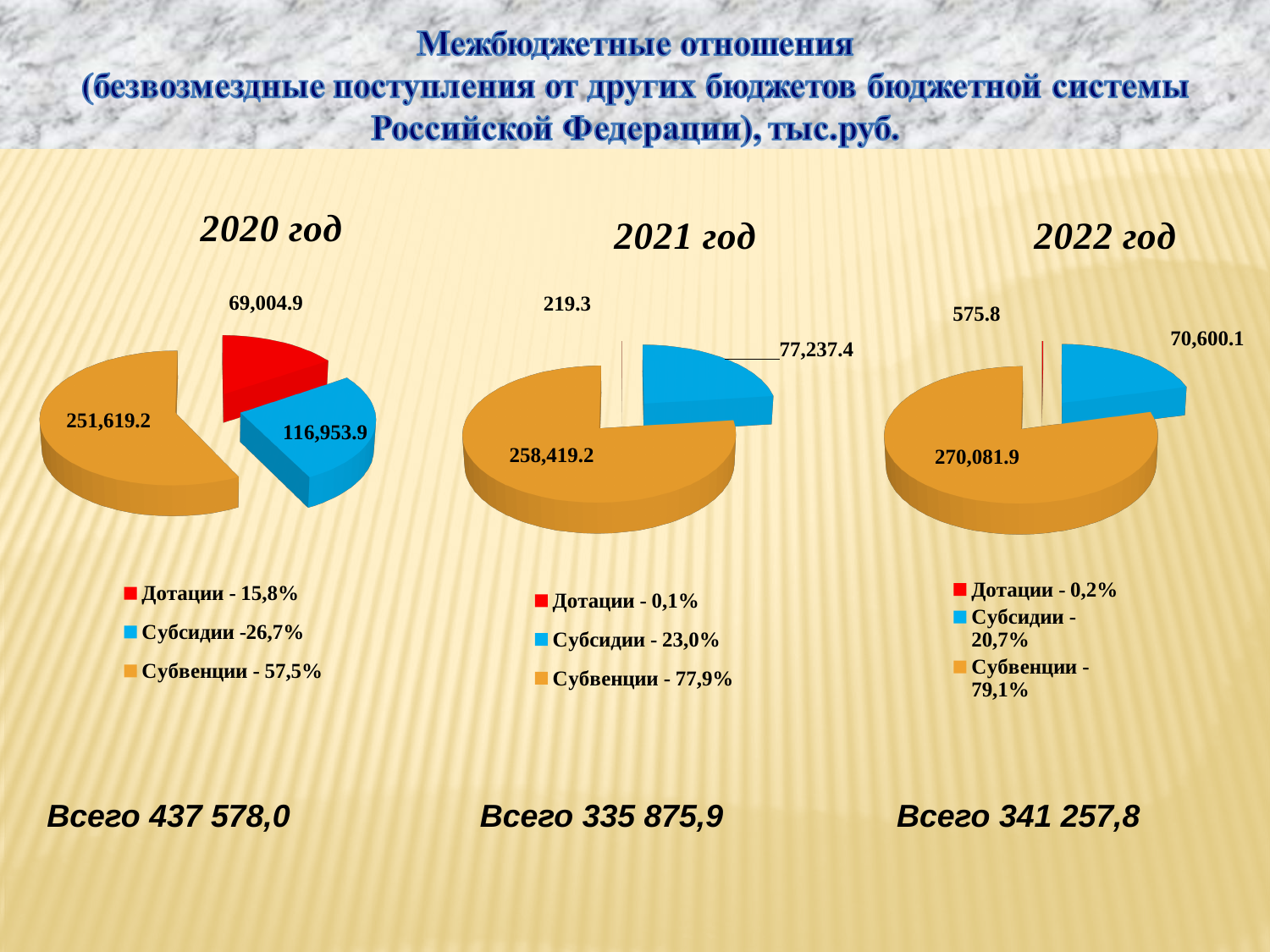
In the 2020 год chart, what is the difference between Субвенции and Субсидии? 134,665.3 In the 2021 год chart, what is the value for Субсидии? 77,237.4 What kind of chart is the 2021 год chart? Pie chart In the 2020 год chart, which category has the largest slice? Субвенции In the 2022 год chart, which is larger, Субсидии or Дотации? Субсидии In the 2021 год chart, which category has the smallest slice? Дотации In the 2020 год chart, what is the value for Субвенции? 251,619.2 In the 2022 год chart, what share of the pie is Субсидии? 20,7% In the 2022 год chart, what is the difference between Субсидии and Дотации? 70,024.3 In the 2021 год chart, what share of the pie is Субвенции? 77,9% In the 2022 год chart, what is the value for Дотации? 575.8 How many slices does the 2020 год chart have? 3